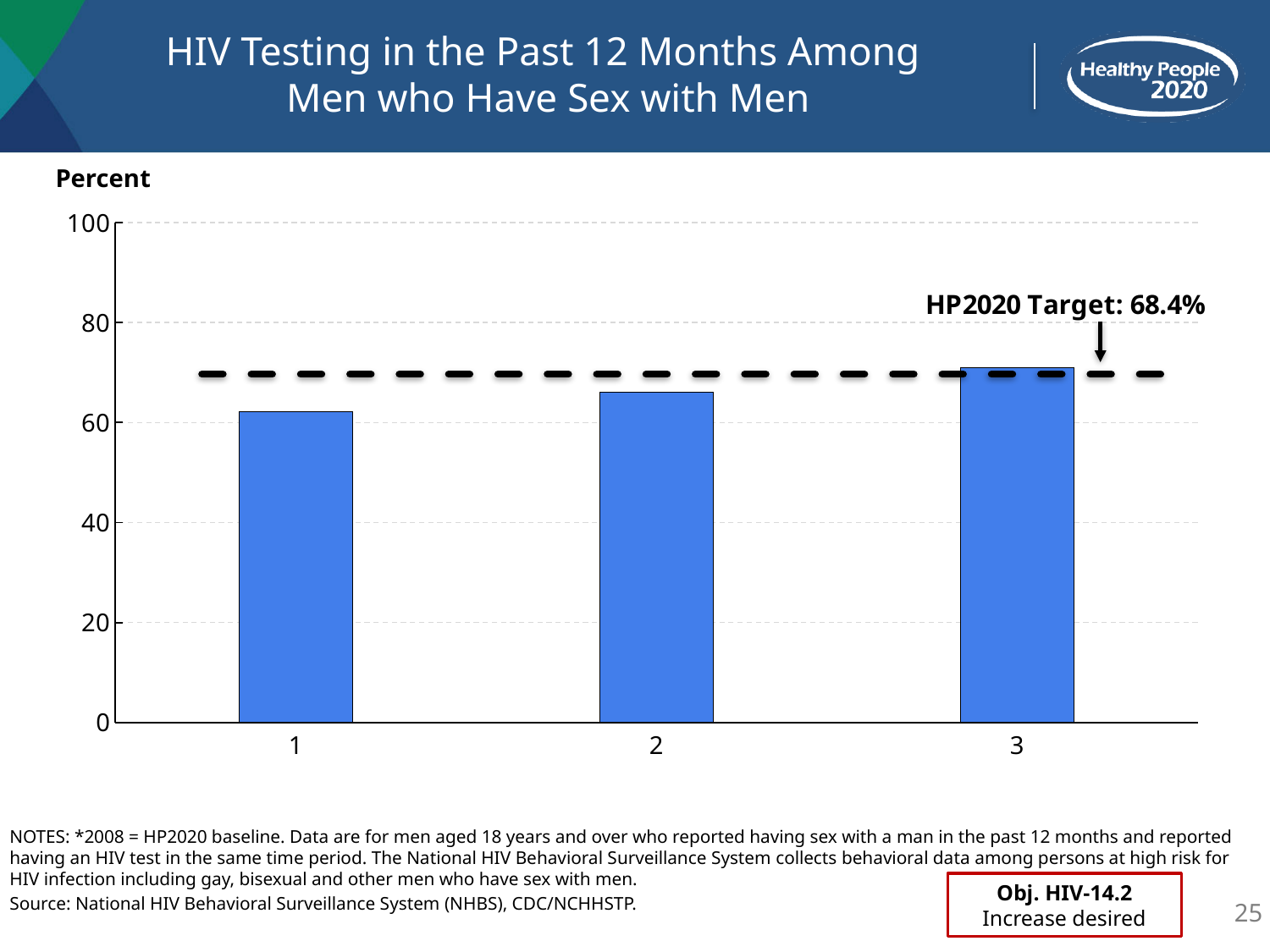
What label is shown on the vertical axis of the chart? Percent Which is larger, the value for category 2 or the value for category 3? 3 Which category has the lowest bar? 1 How many bars are plotted in the chart? 3 Is the value for category 1 greater or less than 40? greater Do the bar values rise or fall from category 1 to category 3? rise Is the value for category 2 greater or less than 60? greater What kind of chart is shown on the slide? bar chart Is the value for category 1 greater or less than 80? less Which category has the highest bar? 3 What is the HP2020 Target value shown on the chart? 68.4%